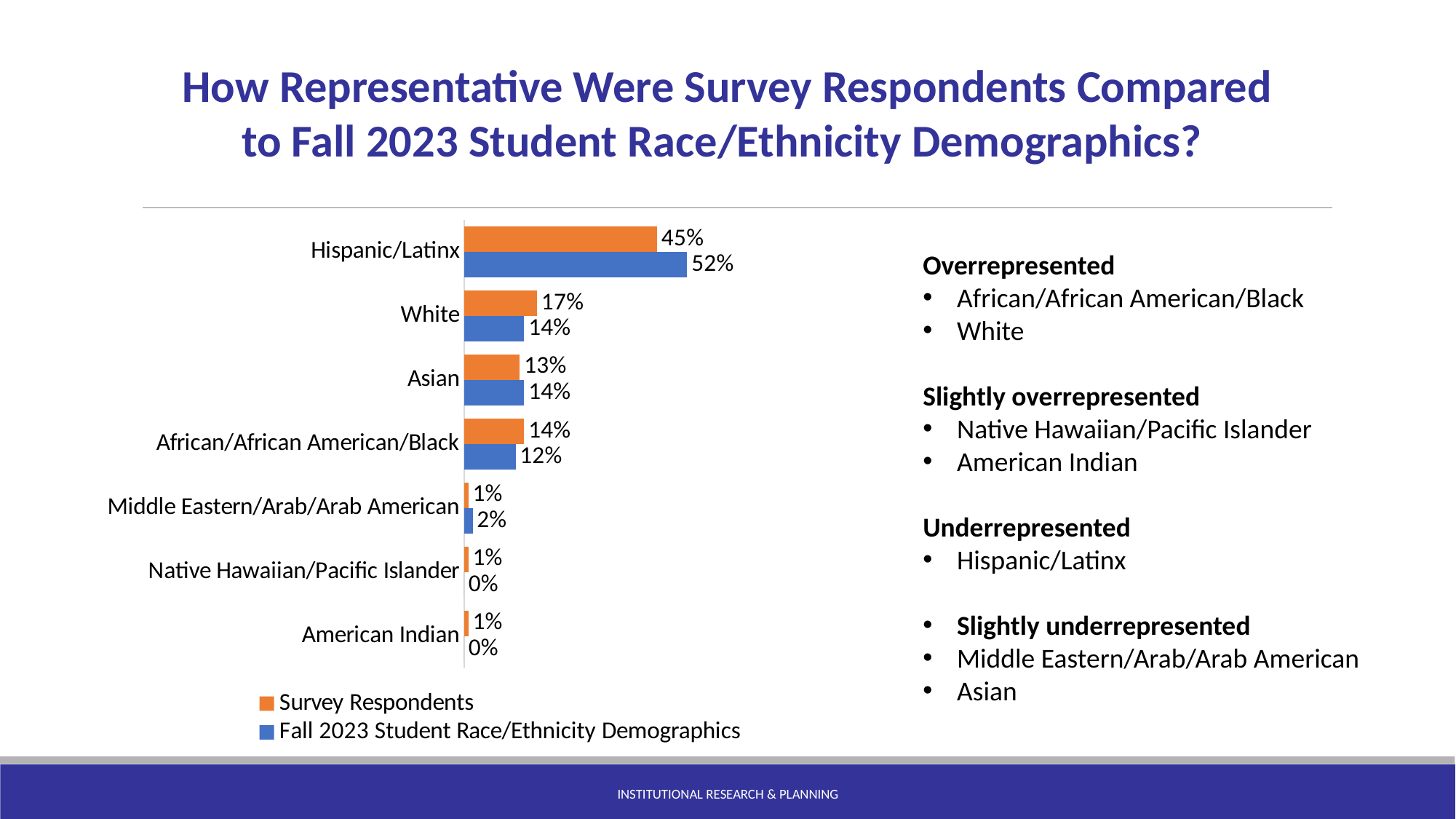
What percentage of Survey Respondents were African/African American/Black? 14% How many race/ethnicity categories are shown in the chart? 7 For Asian, which is larger: the Survey Respondents value or the Fall 2023 Student Race/Ethnicity Demographics value? Fall 2023 Student Race/Ethnicity Demographics What is the difference between the Fall 2023 Student Race/Ethnicity Demographics value and the Survey Respondents value for Hispanic/Latinx? 7% What kind of chart is shown on the slide? Bar chart Which category has the highest Survey Respondents value? Hispanic/Latinx What percentage of Survey Respondents were Hispanic/Latinx? 45% What is the Fall 2023 Student Race/Ethnicity Demographics value for White? 14% What is the Fall 2023 Student Race/Ethnicity Demographics value for Middle Eastern/Arab/Arab American? 2% What is the difference between the Survey Respondents value and the Fall 2023 Student Race/Ethnicity Demographics value for White? 3% How many series does the legend list? 2 Which colour represents Survey Respondents in the chart? Orange